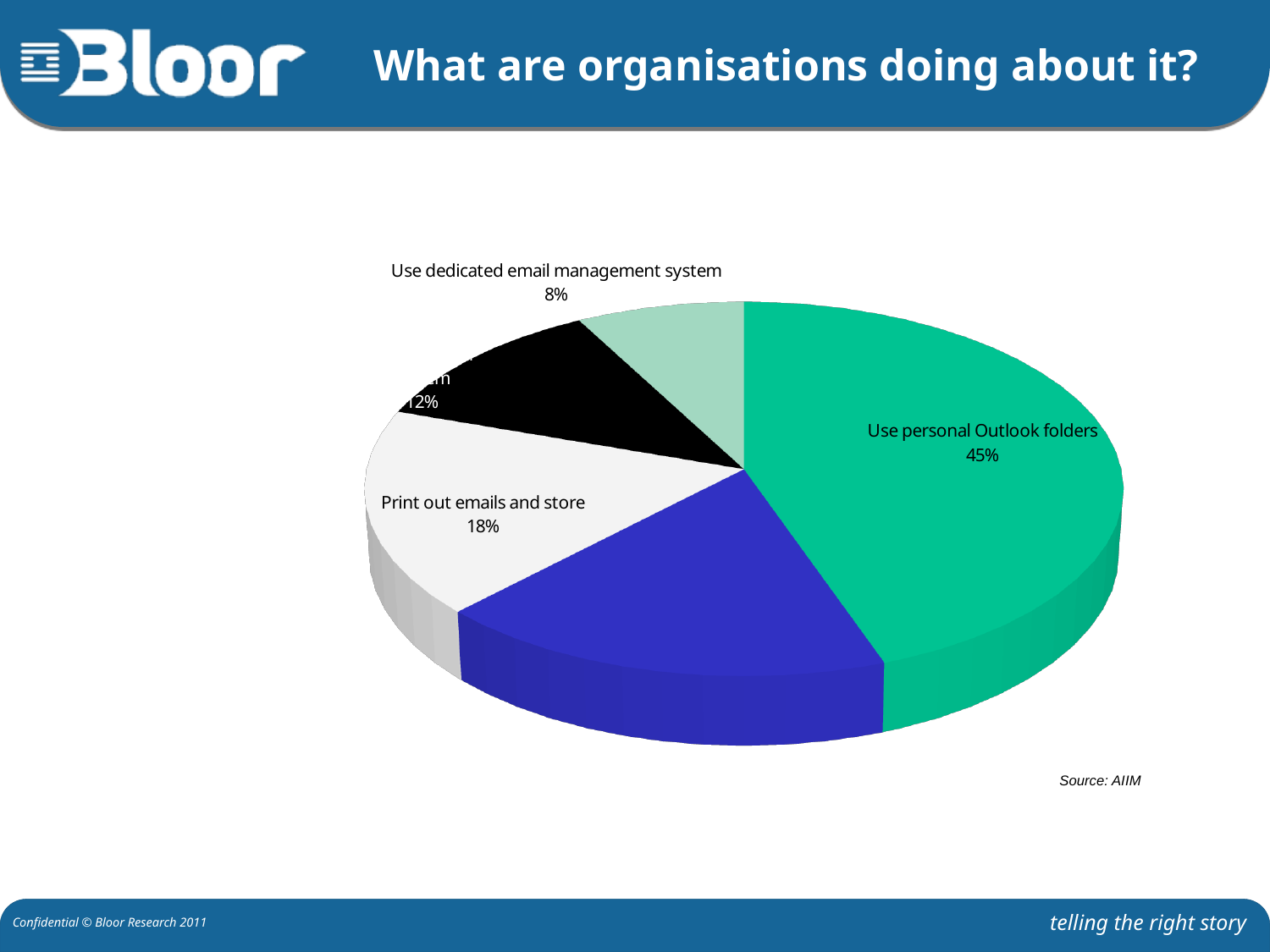
What percentage of organisations use a dedicated email management system? 8% What kind of chart is shown on the slide? pie chart What is the title of the slide containing the pie chart? What are organisations doing about it? What percentage of organisations print out emails and store them? 18% What source is cited for the pie chart data? AIIM Which category has the smallest slice of the pie? Use dedicated email management system How many percentage points larger is 'Use personal Outlook folders' than 'Print out emails and store'? 27 percentage points What percentage of organisations use personal Outlook folders? 45% Which category has the largest slice of the pie? Use personal Outlook folders What is the difference in percentage points between 'Print out emails and store' and 'Use dedicated email management system'? 10 percentage points How many slices does the pie chart have? 5 Which is larger: the share for 'Print out emails and store' or the share for 'Use dedicated email management system'? Print out emails and store